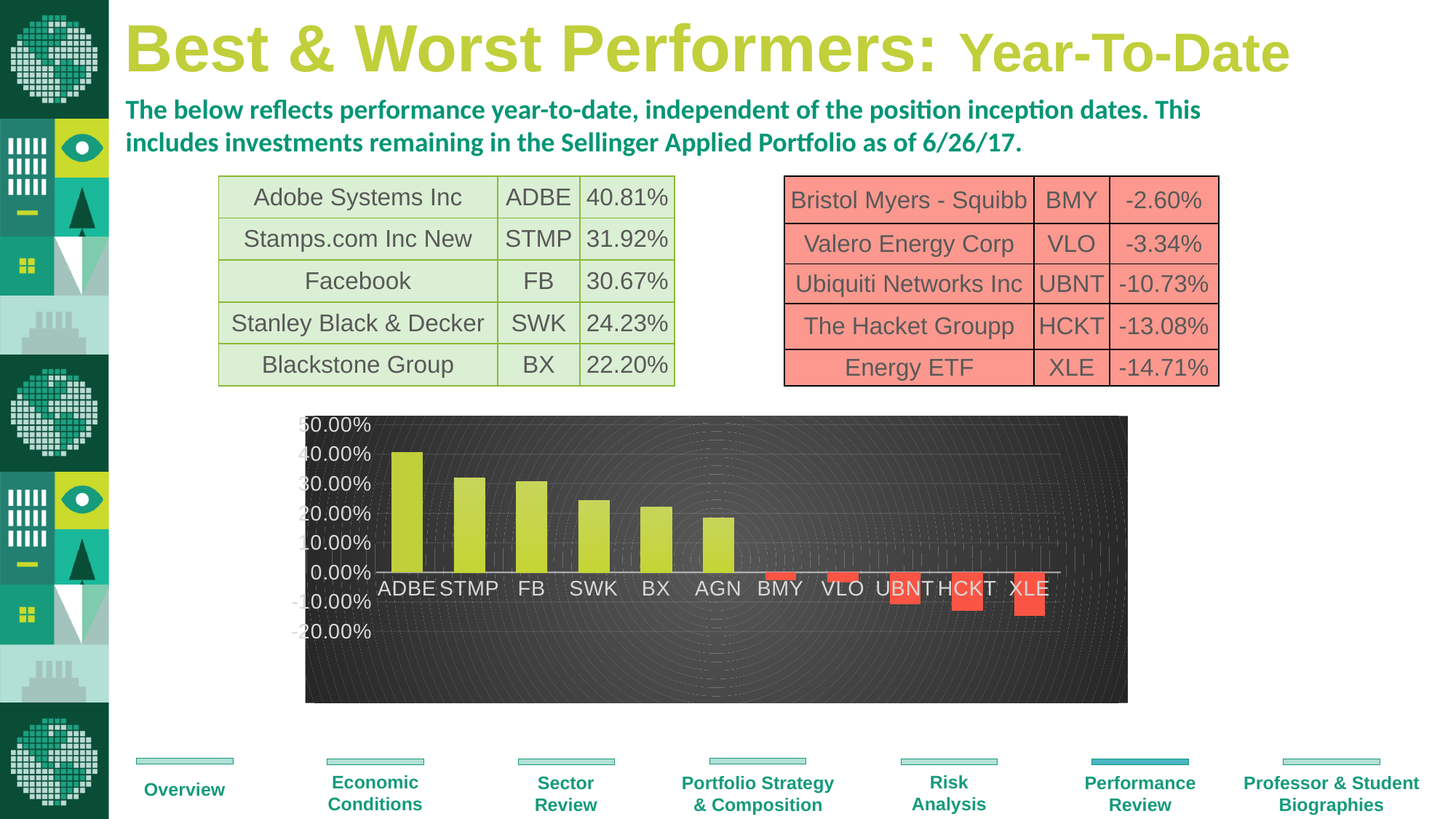
What is the year-to-date performance for ADBE? 40.81% Which ticker has the highest year-to-date performance in the chart? ADBE Do the bar values rise or fall moving from left to right along the x axis? fall Which has the larger year-to-date performance, FB or SWK? FB How many bars (tickers) are plotted in the chart? 11 What colour are the bars for the negative-performing tickers in the chart? red What kind of chart is shown on the slide? bar chart What is the difference between the year-to-date performance of ADBE and STMP? 8.89% Is the value for XLE greater or less than -10.00%? less Which ticker has the lowest year-to-date performance in the chart? XLE What is the year-to-date performance for HCKT? -13.08% Is the value for AGN greater or less than 10.00%? greater